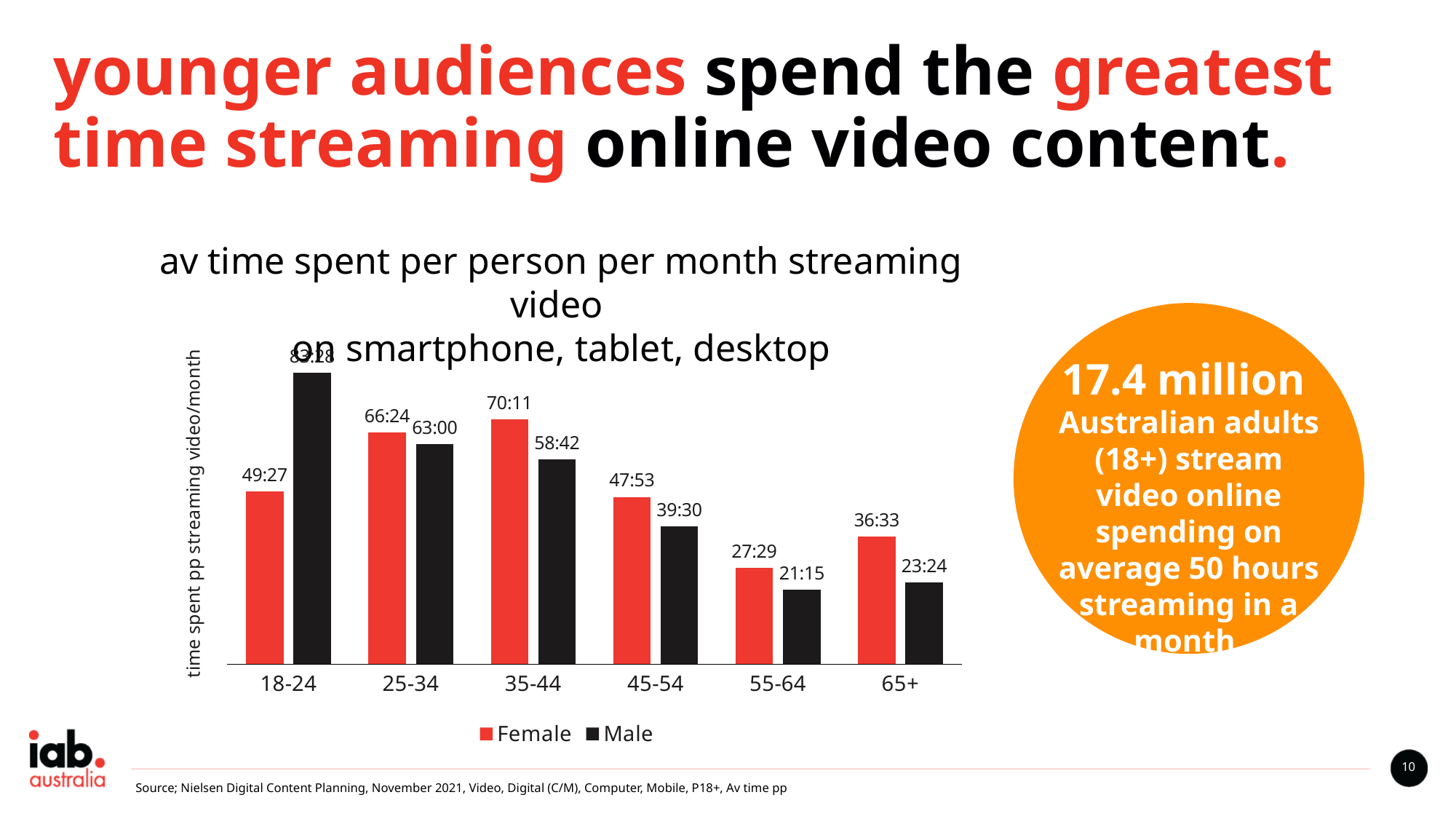
What is the Female value for the 65+ age group? 36:33 What is the Male value for the 55-64 age group? 21:15 What is the Female value for the 35-44 age group? 70:11 How many series does the legend list? 2 Which age group has the highest Male value? 18-24 Which age group has the highest Female value? 35-44 Which is larger for the 18-24 age group, the Female value or the Male value? Male What is the Male value for the 45-54 age group? 39:30 What is the difference between the Female and Male values for the 25-34 age group? 3:24 What kind of chart is shown on the slide? Bar chart Which age group has the lowest Female value? 55-64 How many age groups are shown on the x axis? 6